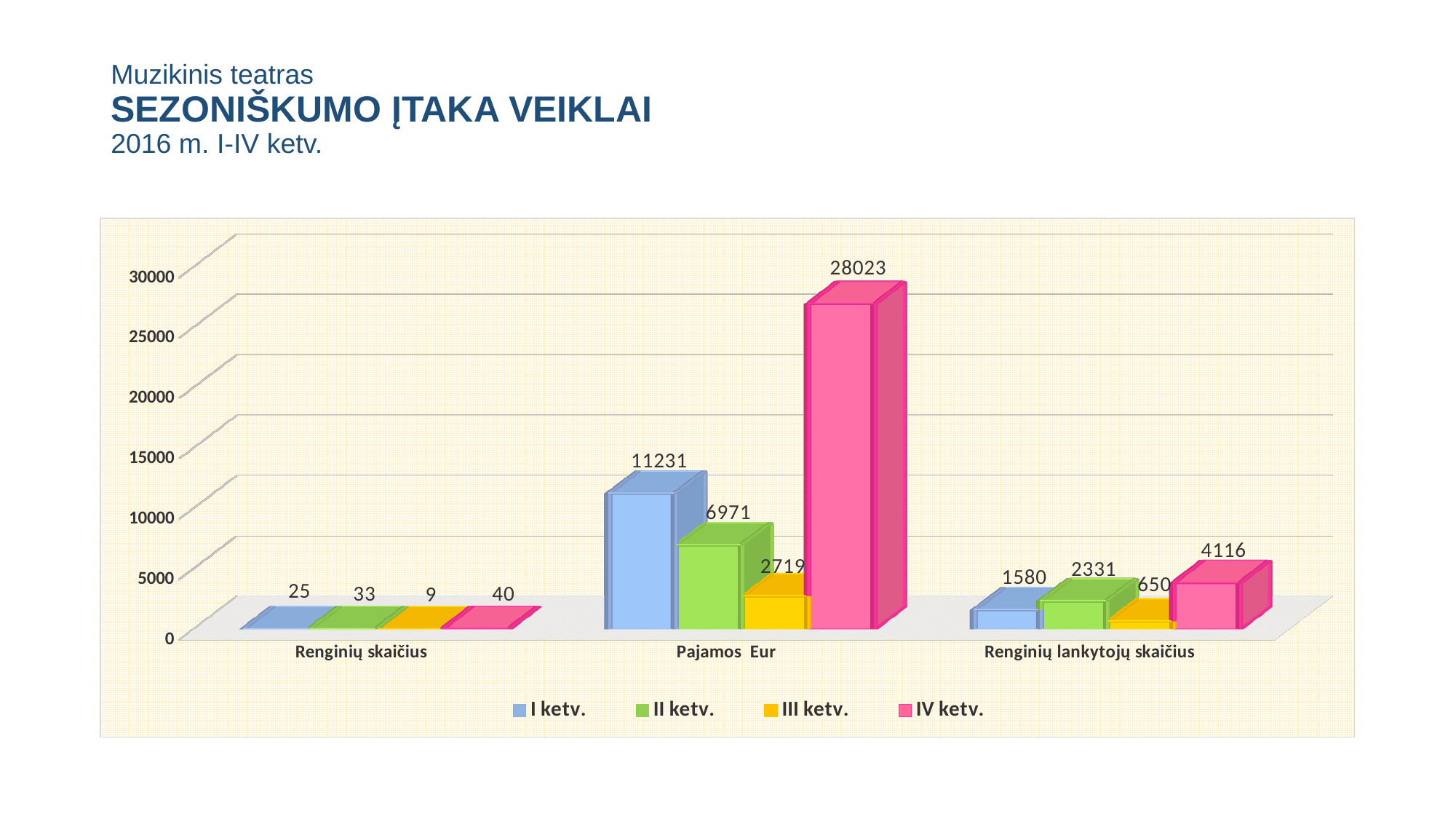
How many categories are shown on the x axis? 3 Is the value for I ketv. in the Pajamos Eur category greater or less than 10000? greater What is the difference between the II ketv. and I ketv. values in the Renginių skaičius category? 8 What is the value for III ketv. in the Renginių skaičius category? 9 Which quarter has the highest value in the Pajamos Eur category? IV ketv. Which quarter has the lowest value in the Renginių lankytojų skaičius category? III ketv. What is the value for IV ketv. in the Pajamos Eur category? 28023 What is the difference between the IV ketv. and I ketv. values in the Pajamos Eur category? 16792 What kind of chart is shown on the slide? Bar chart Which is larger in the Renginių lankytojų skaičius category: I ketv. or II ketv.? II ketv. How many series does the legend list? 4 What is the value for II ketv. in the Renginių lankytojų skaičius category? 2331